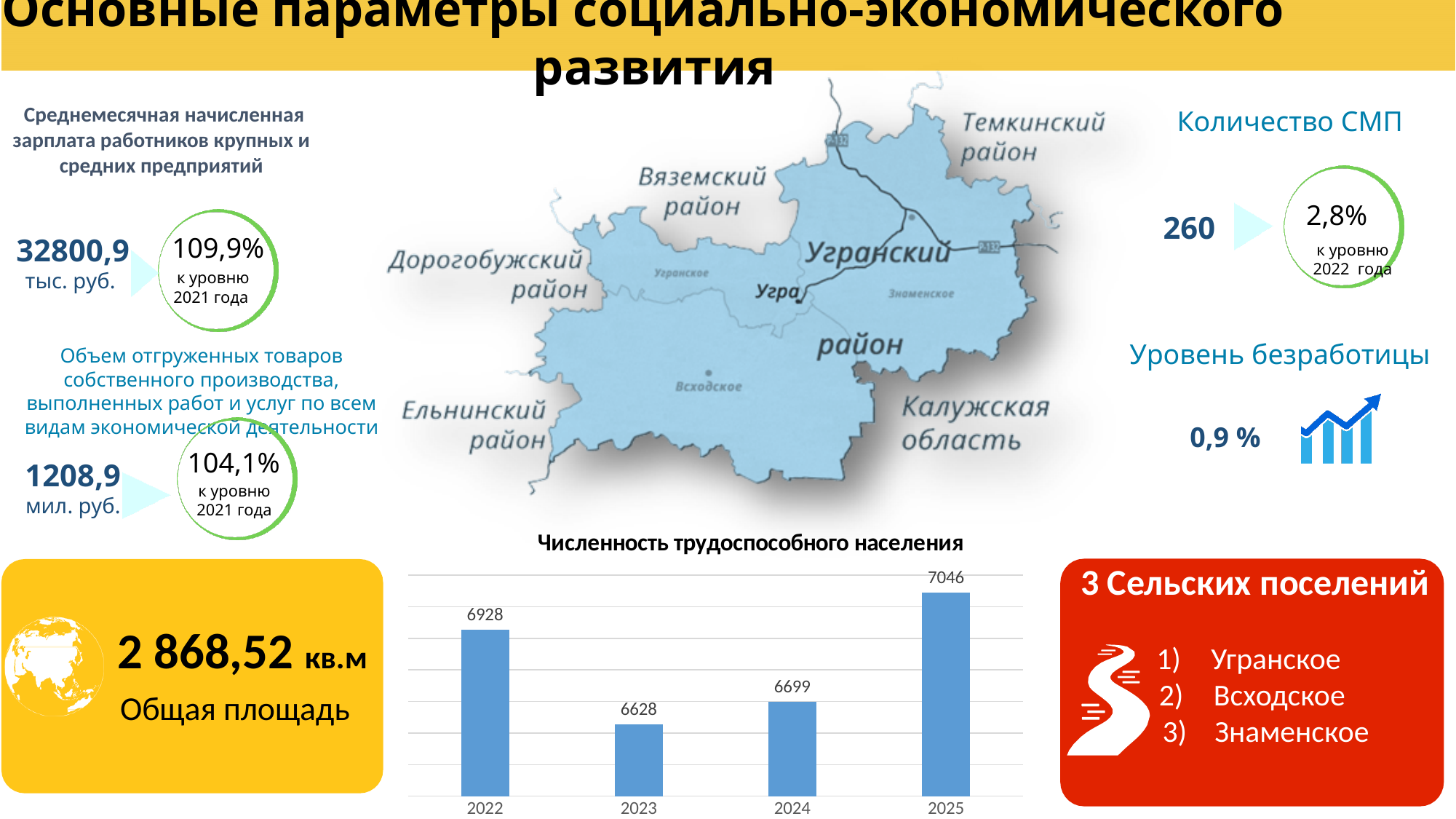
Which year has the highest value in the chart 'Численность трудоспособного населения'? 2025 What is the value for 2024 in the chart 'Численность трудоспособного населения'? 6699 In the chart 'Численность трудоспособного населения', which is larger: the value for 2024 or the value for 2023? 2024 What is the difference between the 2022 and 2023 values in the chart 'Численность трудоспособного населения'? 300 What is the value for 2022 in the chart 'Численность трудоспособного населения'? 6928 What is the title of the bar chart on the slide? Численность трудоспособного населения What kind of chart is 'Численность трудоспособного населения'? bar chart What is the value for 2023 in the chart 'Численность трудоспособного населения'? 6628 How many years are shown in the chart 'Численность трудоспособного населения'? 4 What is the difference between the 2025 and 2022 values in the chart 'Численность трудоспособного населения'? 118 What is the value for 2025 in the chart 'Численность трудоспособного населения'? 7046 Which year has the lowest value in the chart 'Численность трудоспособного населения'? 2023